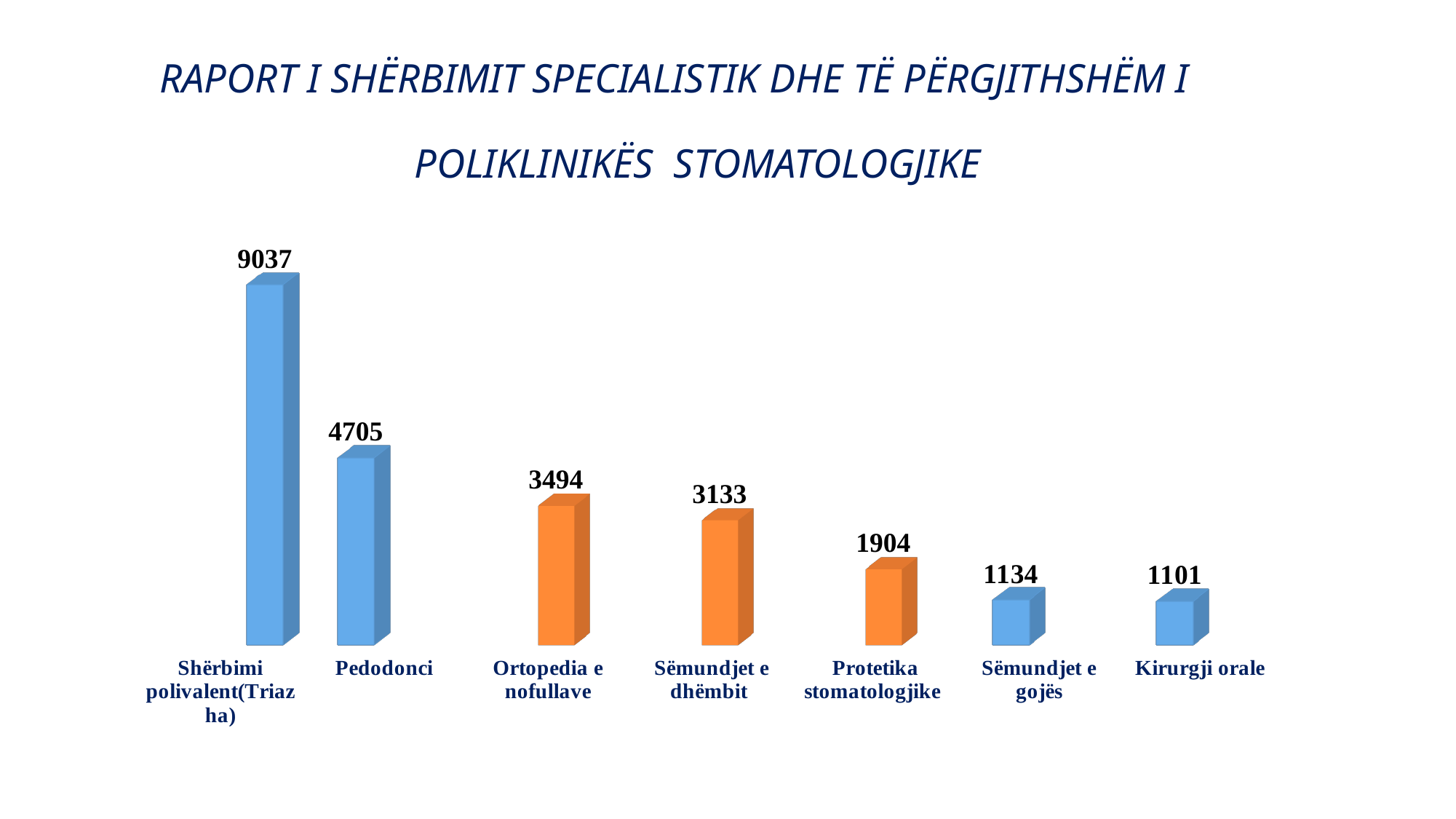
What kind of chart is shown on the slide? Bar chart Do the values rise or fall from left to right along the x axis? Fall What is the value for Pedodonci? 4705 Which category has the highest value? Shërbimi polivalent(Triazha) Which is larger, the value for Sëmundjet e gojës or the value for Protetika stomatologjike? Protetika stomatologjike What is the difference between the values for Shërbimi polivalent(Triazha) and Pedodonci? 4332 What is the value for Kirurgji orale? 1101 What colour are the bars for Ortopedia e nofullave, Sëmundjet e dhëmbit and Protetika stomatologjike? Orange What is the value for Protetika stomatologjike? 1904 How many categories are shown in the chart? 7 Which category has the lowest value? Kirurgji orale What is the difference between the values for Ortopedia e nofullave and Sëmundjet e dhëmbit? 361